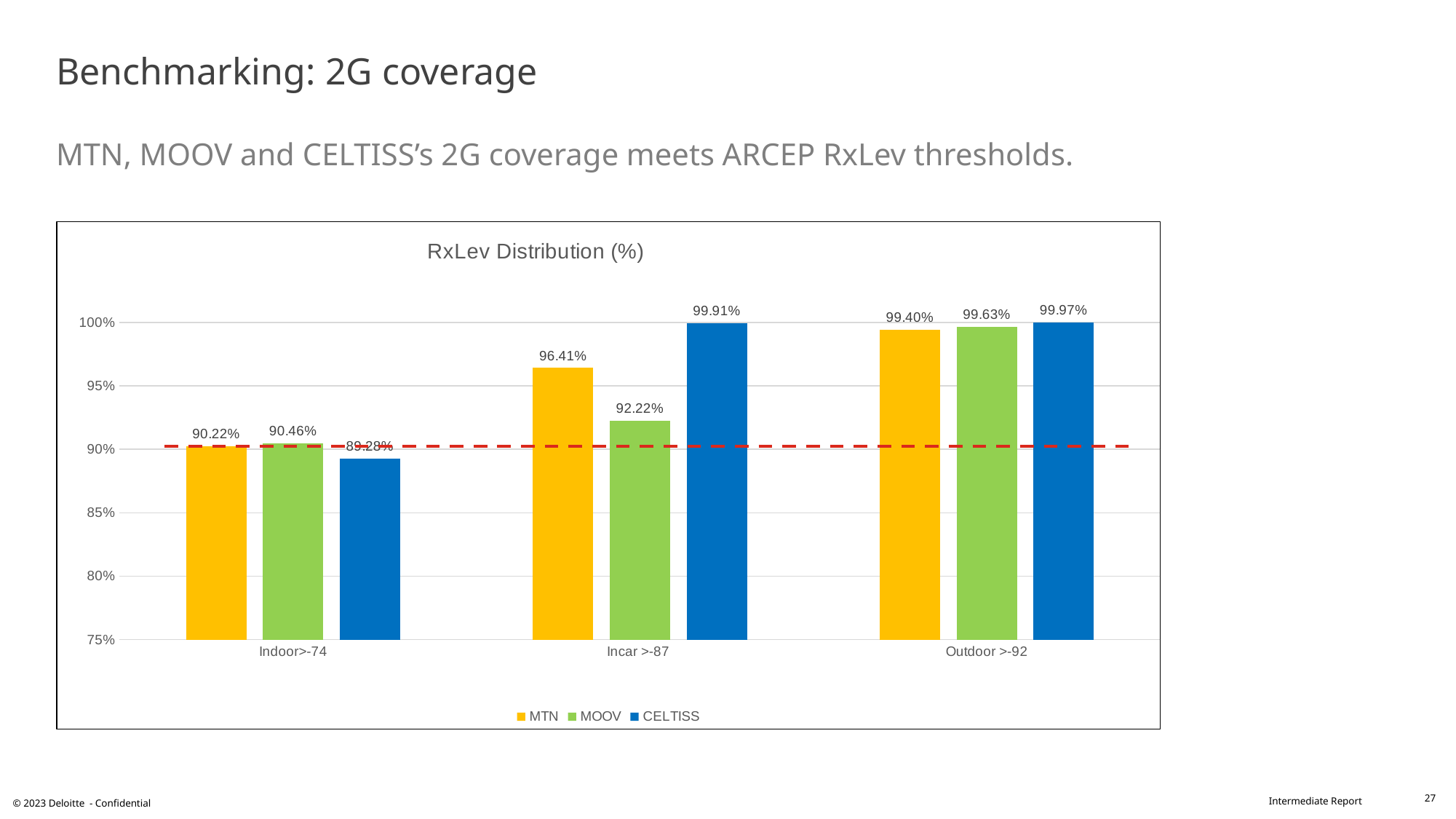
Is the value for CELTISS in the Indoor>-74 category greater or less than 90%? less What is the value for MOOV in the Outdoor >-92 category? 99.63% What is the difference between the MTN values for Outdoor >-92 and Indoor>-74? 9.18% Which operator has the highest value in the Incar >-87 category? CELTISS How many categories are shown on the x axis? 3 What is the value for MTN in the Indoor>-74 category? 90.22% What type of chart is shown on the slide? bar chart What is the value for CELTISS in the Incar >-87 category? 99.91% What is the difference between the CELTISS and MOOV values in the Incar >-87 category? 7.69% Which is larger: MTN's value for Incar >-87 or MOOV's value for Incar >-87? MTN How many series does the legend list? 3 Which operator has the lowest value in the Indoor>-74 category? CELTISS